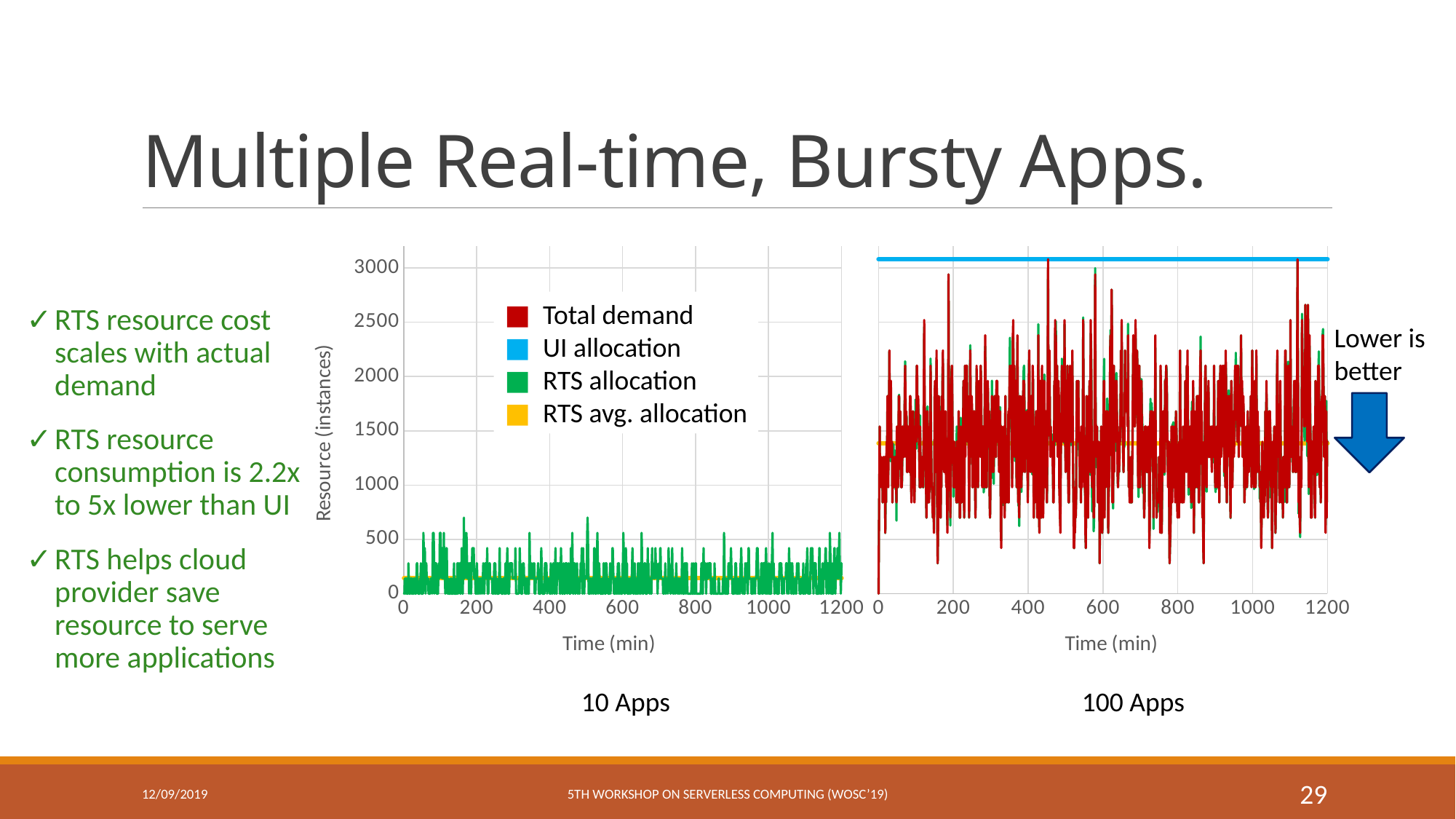
How many charts are shown on the slide? 2 What kind of chart is the "10 Apps" chart on the left? line chart How many series does the legend list for the charts? 4 Which series in the "100 Apps" chart is drawn as a flat line at the top of the plot? UI allocation In the "100 Apps" chart, is the UI allocation value greater or less than 2500? greater In the "10 Apps" chart, is the RTS allocation ever greater than 1000? No What is the highest tick value shown on the x axis of the "10 Apps" chart? 1200 What is the label of the x axis on the "100 Apps" chart? Time (min) What is the label of the y axis shared by the two charts? Resource (instances) In the "100 Apps" chart, which is larger, the UI allocation or the RTS avg. allocation? UI allocation In the "10 Apps" chart, is the RTS avg. allocation value greater or less than 500? less